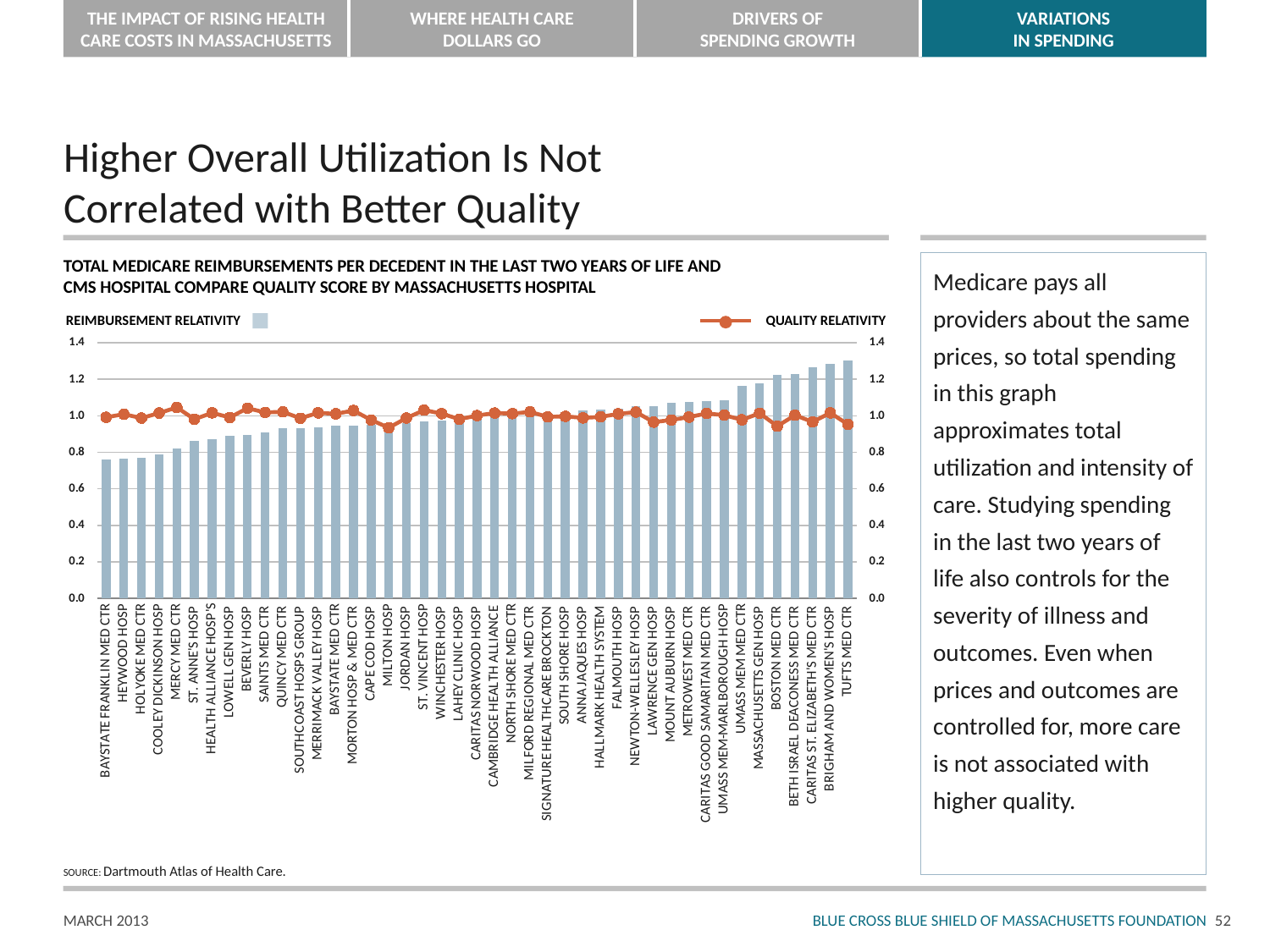
How many series does the chart's legend list? 2 Which hospital has the highest reimbursement relativity bar? Tufts Med Ctr Is the reimbursement relativity for Brigham and Women's Hosp greater or less than 1.2? greater Which has the larger reimbursement relativity, Tufts Med Ctr or Heywood Hosp? Tufts Med Ctr Is the reimbursement relativity for Milton Hosp greater or less than 1.0? less What kind of chart is shown on the slide? A bar chart with a line overlay Is the reimbursement relativity for Baystate Franklin Med Ctr greater or less than 0.8? less Which series is plotted as the orange line with markers? Quality relativity Do the reimbursement relativity bars rise or fall from left to right across the hospitals? Rise Which hospital has the lowest reimbursement relativity bar? Baystate Franklin Med Ctr How many hospitals are shown on the x axis of the chart? 43